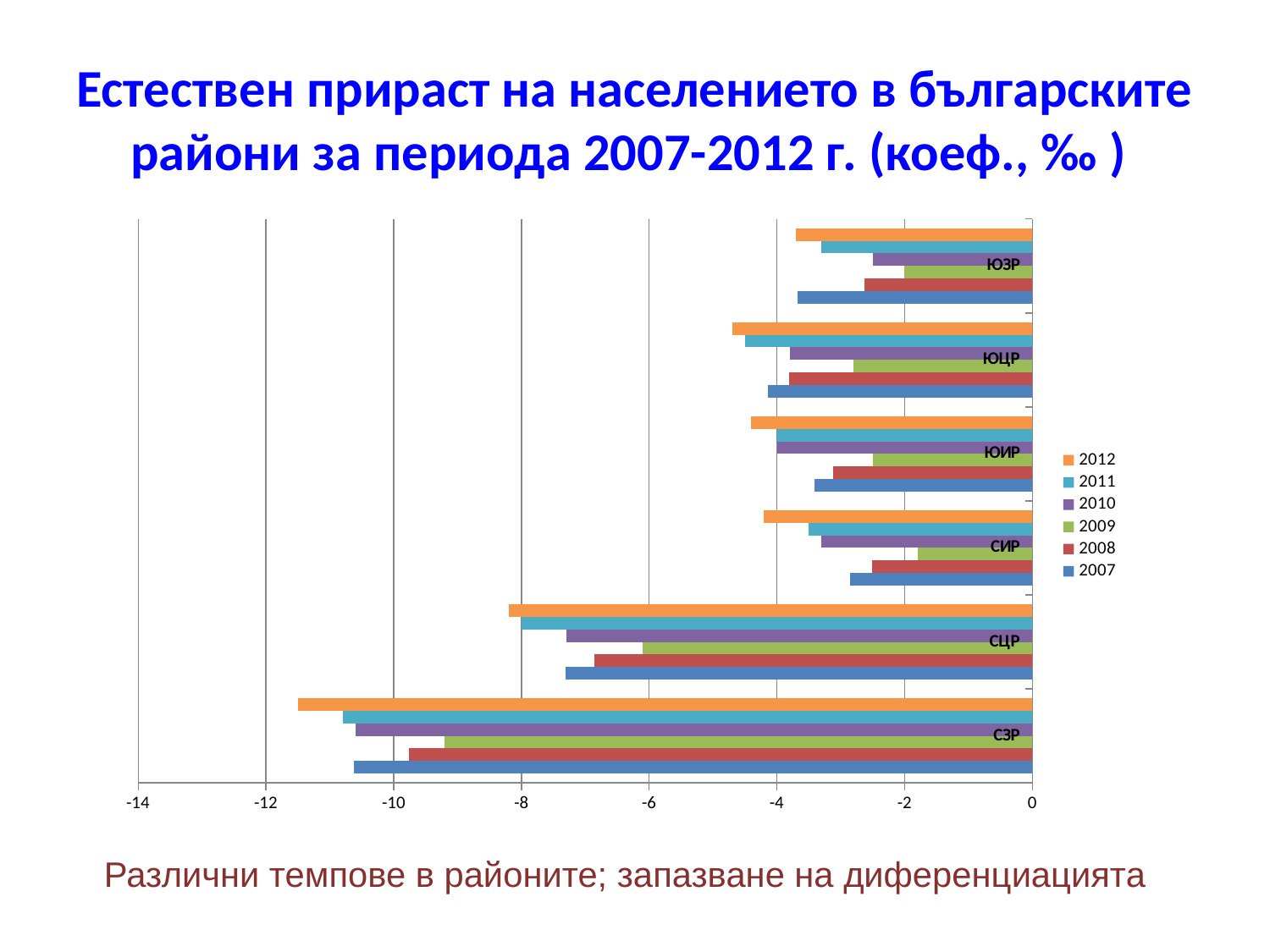
Is the value for ЮЗР in 2012 greater or less than -4? greater Which year is shown in orange in the legend? 2012 What kind of chart is shown on the slide? bar chart Is the value for СЗР in 2012 greater or less than -10? less Is the value for СЦР in 2007 greater or less than -8? greater How many regions (categories) are shown on the chart? 6 Which is larger, the 2012 value for СЗР or the 2012 value for СЦР? СЦР Which is larger, the 2009 value for ЮЗР or the 2009 value for СЦР? ЮЗР Which region has the highest (closest to zero) value for 2009? СИР How many series does the legend list? 6 Which region has the lowest (most negative) value for 2012? СЗР